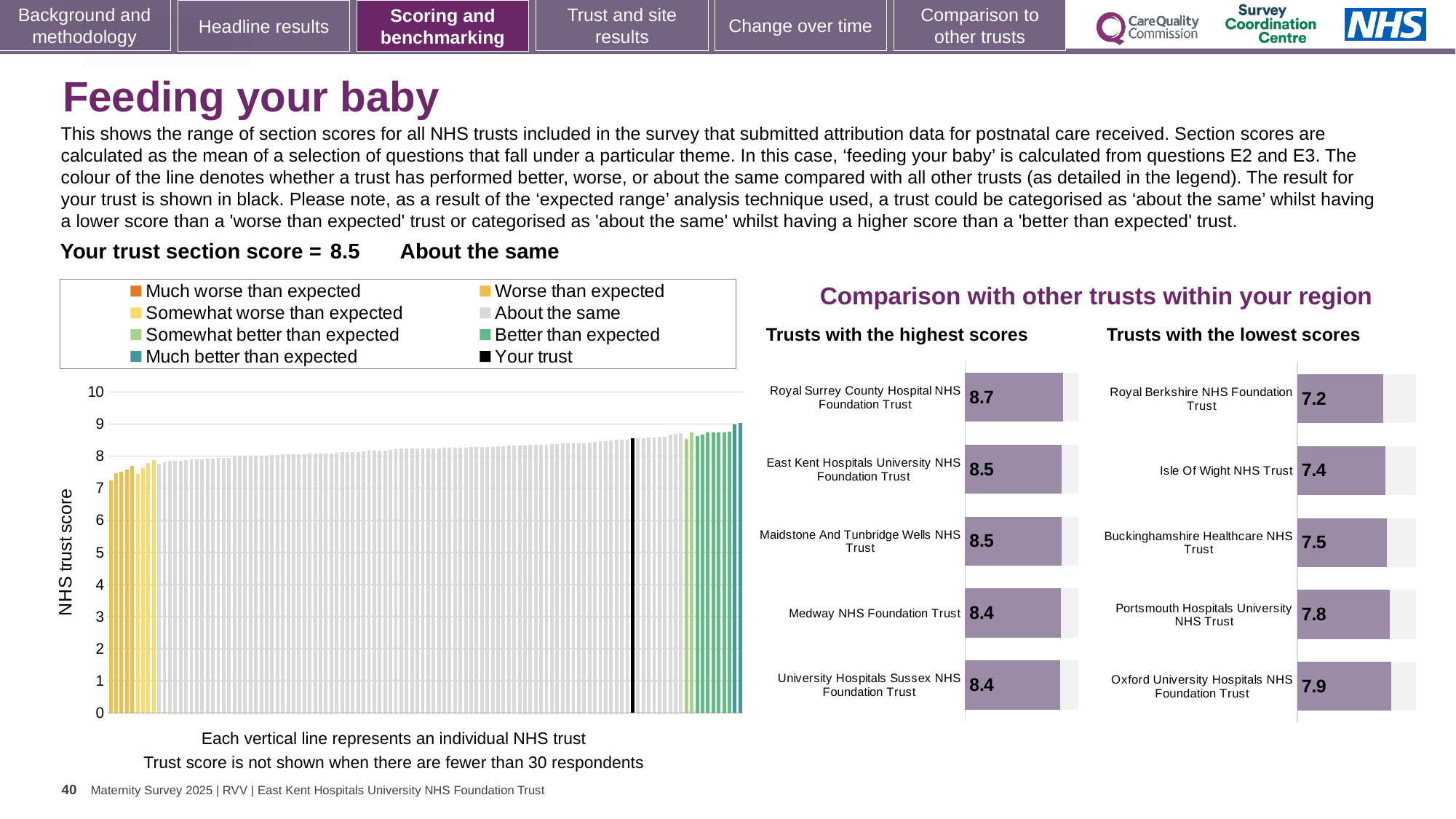
In the 'Trusts with the highest scores' chart, what is the score for Royal Surrey County Hospital NHS Foundation Trust? 8.7 In the 'Trusts with the lowest scores' chart, what is the difference between the scores of Oxford University Hospitals NHS Foundation Trust and Royal Berkshire NHS Foundation Trust? 0.7 In the 'Trusts with the lowest scores' chart, which trust has the lowest score? Royal Berkshire NHS Foundation Trust In the 'Trusts with the highest scores' chart, what is the difference between the scores of Royal Surrey County Hospital NHS Foundation Trust and Medway NHS Foundation Trust? 0.3 What type of chart is the 'NHS trust score' chart on the left of the slide? Bar chart How many entries does the legend of the 'NHS trust score' chart on the left list? 8 How many trusts are shown in the 'Trusts with the lowest scores' chart? 5 In the 'Trusts with the highest scores' chart, which trust has the highest score? Royal Surrey County Hospital NHS Foundation Trust In the 'Trusts with the lowest scores' chart, what is the score for Isle Of Wight NHS Trust? 7.4 In the 'Trusts with the lowest scores' chart, which has the larger score: Portsmouth Hospitals University NHS Trust or Buckinghamshire Healthcare NHS Trust? Portsmouth Hospitals University NHS Trust In the 'NHS trust score' chart on the left, is the value for the black 'Your trust' bar greater or less than 8? greater In the 'NHS trust score' chart on the left, do the values rise or fall from left to right along the x axis? Rise